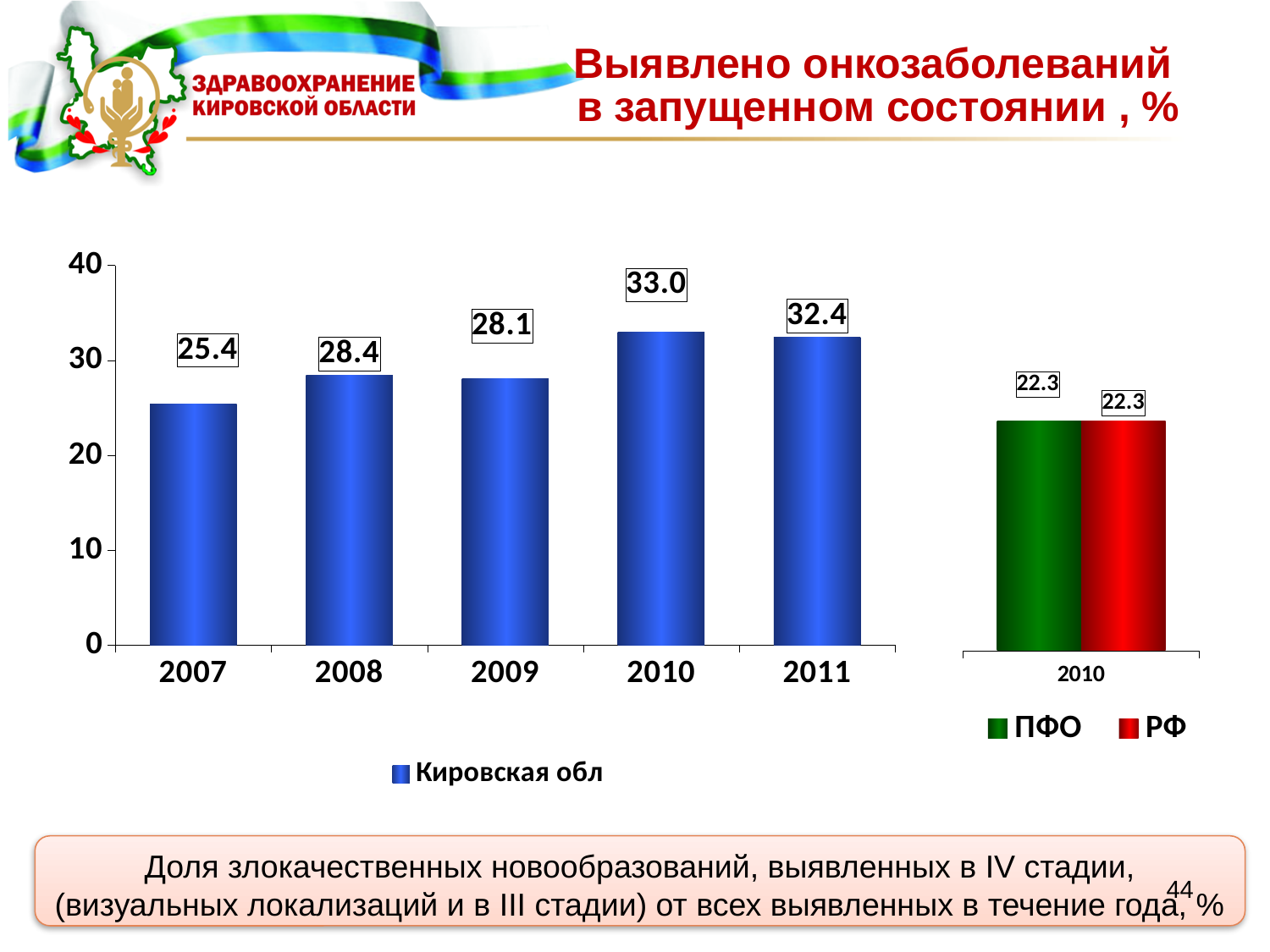
In the right chart, what is the value for ПФО in 2010? 22.3 In the left chart, what is the value for Кировская обл in 2010? 33.0 In the right chart, what is the value for РФ in 2010? 22.3 In the left chart, which is larger, the value for 2008 or the value for 2009? 2008 In the left chart, what is the difference between the values for 2011 and 2007? 7.0 How many series does the legend of the right chart list? 2 In the left chart, what is the value for Кировская обл in 2007? 25.4 In the left chart, which year has the lowest value? 2007 In the right chart, what colour is the bar for РФ? red In the left chart, which year has the highest value? 2010 What kind of chart is the left chart? bar chart In the left chart, how many years are shown on the x axis? 5